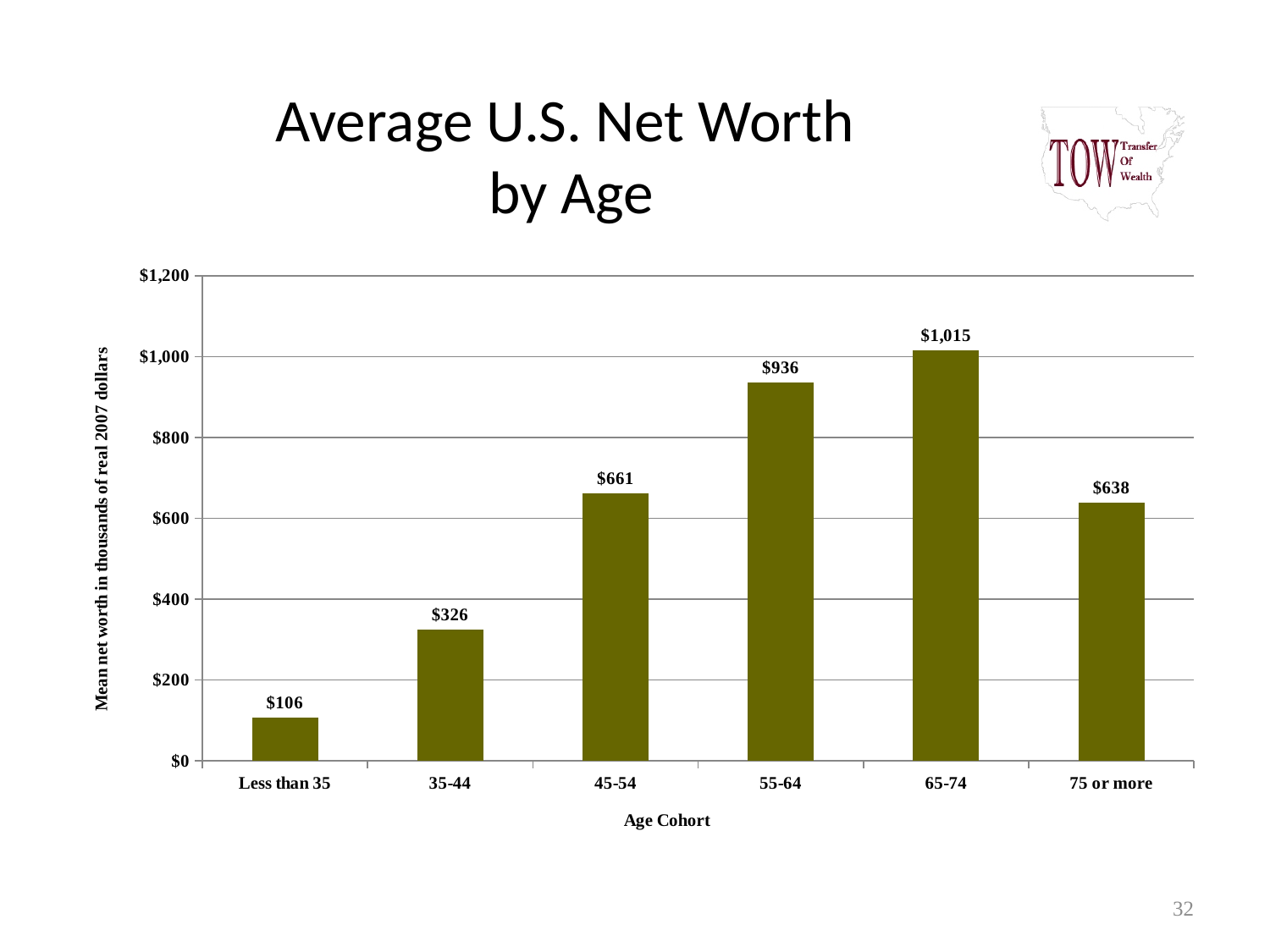
What kind of chart is shown on the slide? Bar chart What is the label of the vertical axis? Mean net worth in thousands of real 2007 dollars What is the difference in mean net worth between the 35-44 and Less than 35 age cohorts? $220 How many age cohorts are shown on the chart? 6 What is the difference in mean net worth between the 65-74 and 55-64 age cohorts? $79 Is the value for the 55-64 age cohort greater or less than $800? greater Which age cohort has the highest mean net worth? 65-74 What is the mean net worth for the Less than 35 age cohort? $106 What is the mean net worth for the 45-54 age cohort? $661 What is the mean net worth for the 75 or more age cohort? $638 Which age cohort has the lowest mean net worth? Less than 35 Which has a higher mean net worth, the 45-54 cohort or the 75 or more cohort? 45-54